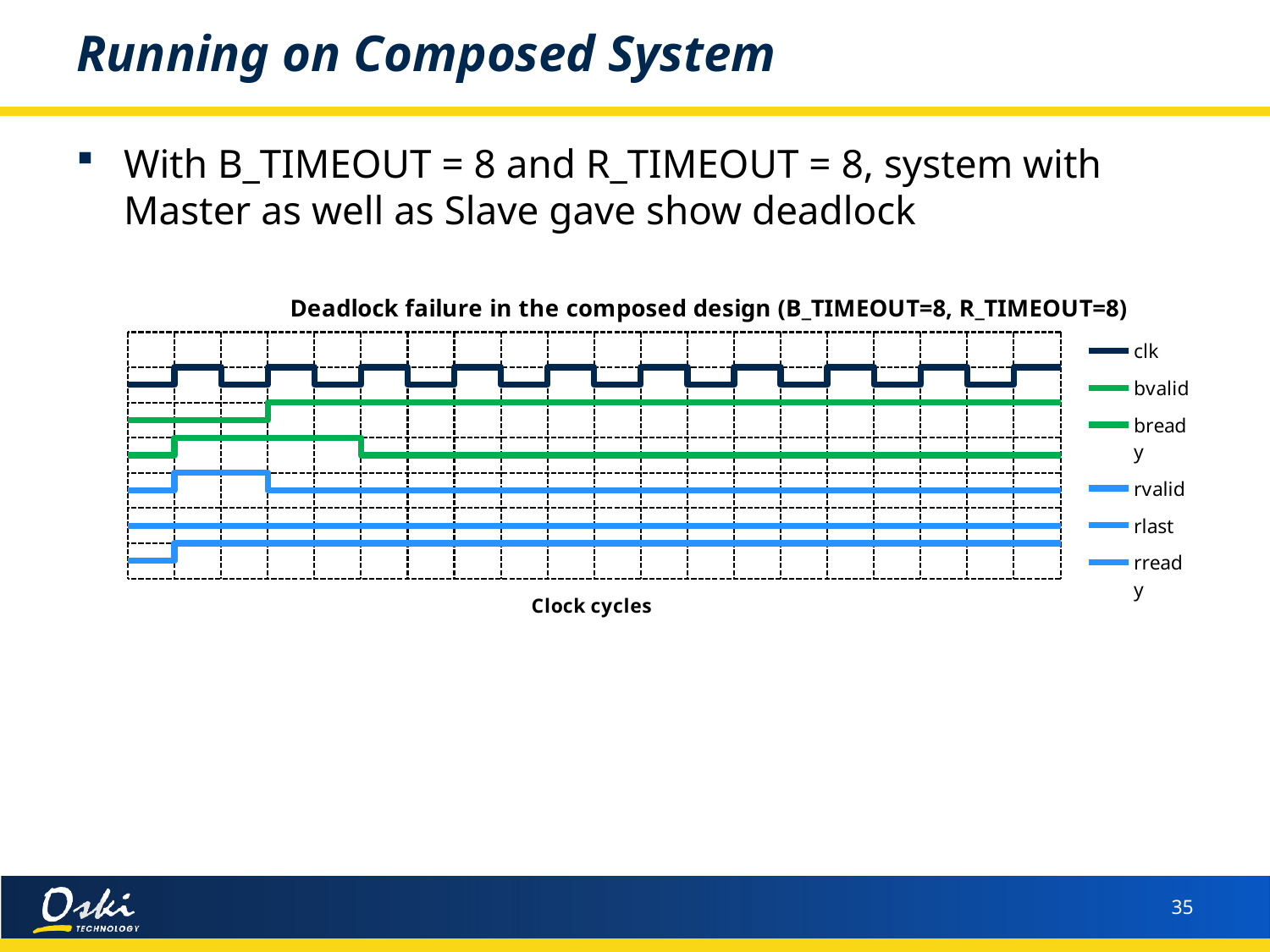
Does the rvalid signal end higher or lower than it starts across the clock cycles? Neither; it ends at the same level it starts (low) What kind of chart is shown on the slide? Line chart (timing diagram) Does the bvalid signal rise or fall as the clock cycles progress? rises What is the label of the x axis of the chart? Clock cycles How many signals (series) does the chart's legend list? 6 What is the title of the chart on the slide? Deadlock failure in the composed design (B_TIMEOUT=8, R_TIMEOUT=8)